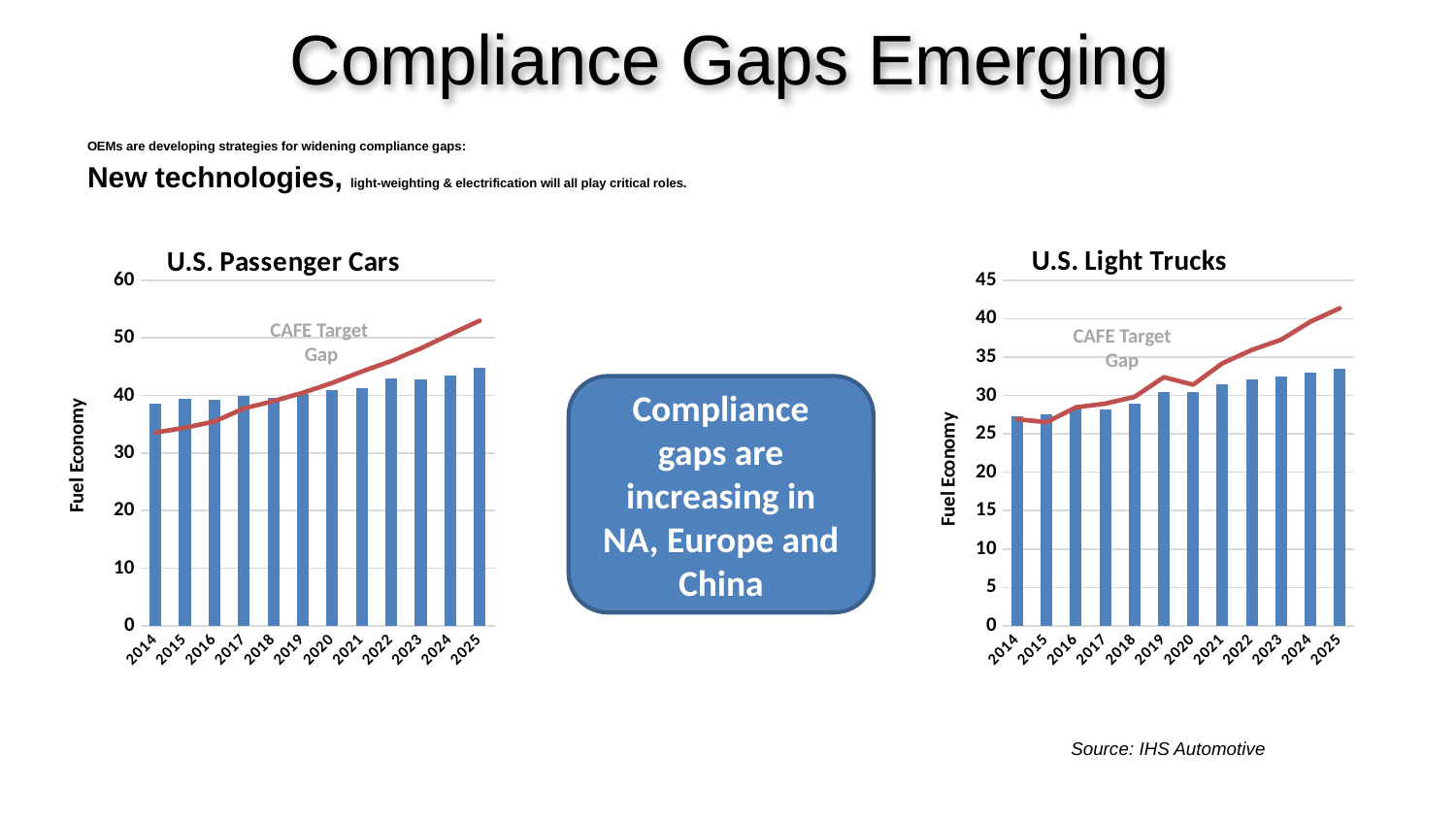
In the U.S. Light Trucks chart, which is larger, the bar value for 2025 or the bar value for 2014? 2025 In the U.S. Light Trucks chart, is the bar value for 2025 greater or less than 30? greater What is the y-axis label on the U.S. Passenger Cars chart? Fuel Economy In the U.S. Light Trucks chart, does the CAFE Target line rise or fall from 2014 to 2025? rise In the U.S. Passenger Cars chart, do the bar values rise or fall from 2014 to 2025? rise In the U.S. Passenger Cars chart, is the bar value for 2025 greater or less than 40? greater In the U.S. Passenger Cars chart, is the CAFE Target line value for 2025 greater or less than 50? greater What kind of chart is the U.S. Passenger Cars chart? bar chart with a line In the U.S. Light Trucks chart, which year has the highest bar? 2025 How many years are shown on the x axis of the U.S. Light Trucks chart? 12 In the U.S. Passenger Cars chart, which year has the highest bar? 2025